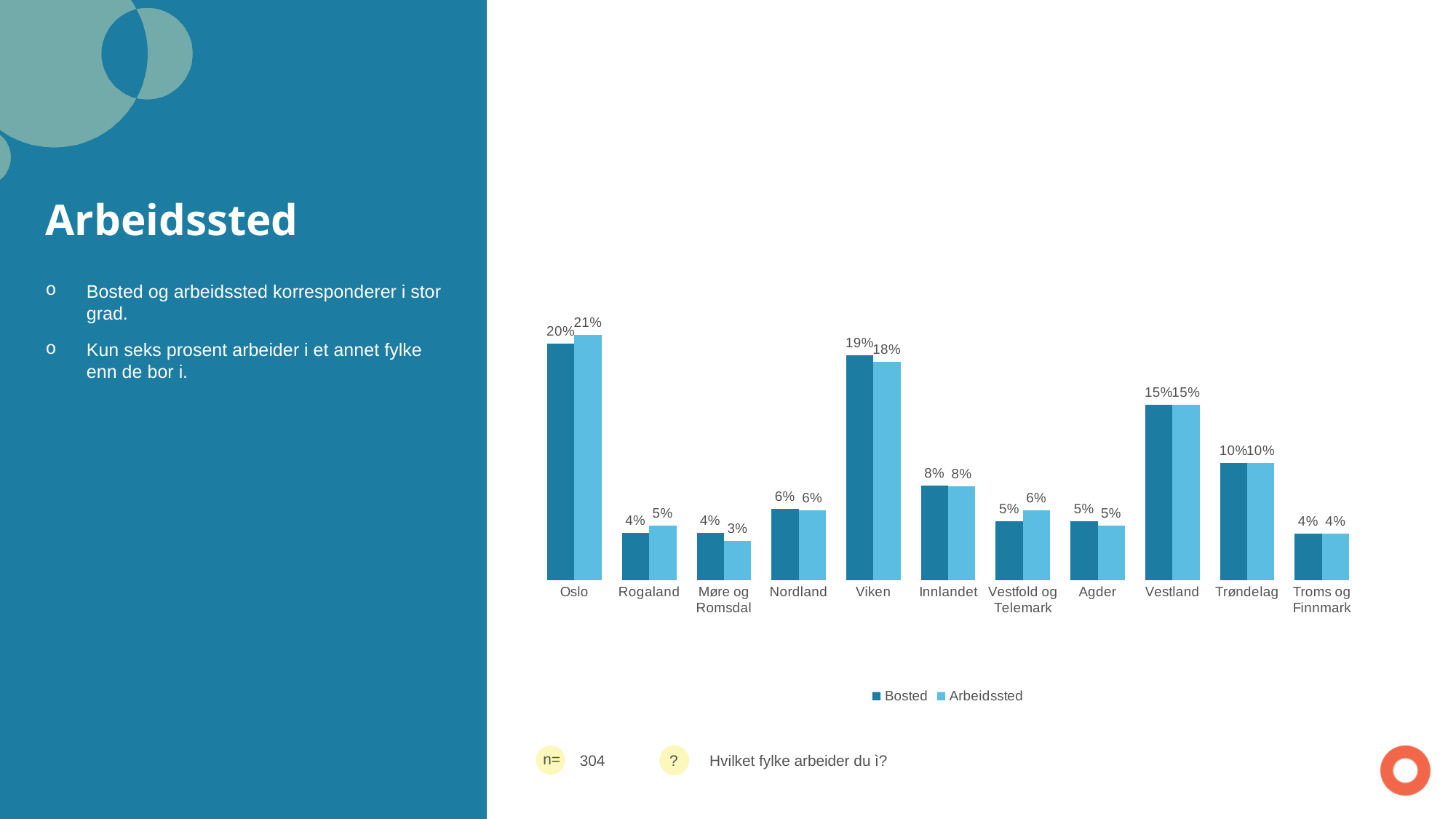
What is the Bosted value for Oslo? 20% What is the Arbeidssted value for Møre og Romsdal? 3% How many series does the legend list? 2 What is the Arbeidssted value for Viken? 18% What kind of chart is shown on the slide? Bar chart What are the two series named in the legend? Bosted and Arbeidssted Which is larger, the Bosted value for Innlandet or the Bosted value for Trøndelag? Trøndelag What is the difference between the Bosted values for Viken and Vestland? 4% What is the difference between the Bosted and Arbeidssted values for Oslo? 1% Which category has the highest Arbeidssted value? Oslo How many categories are shown on the x axis? 11 Which category has the lowest Arbeidssted value? Møre og Romsdal